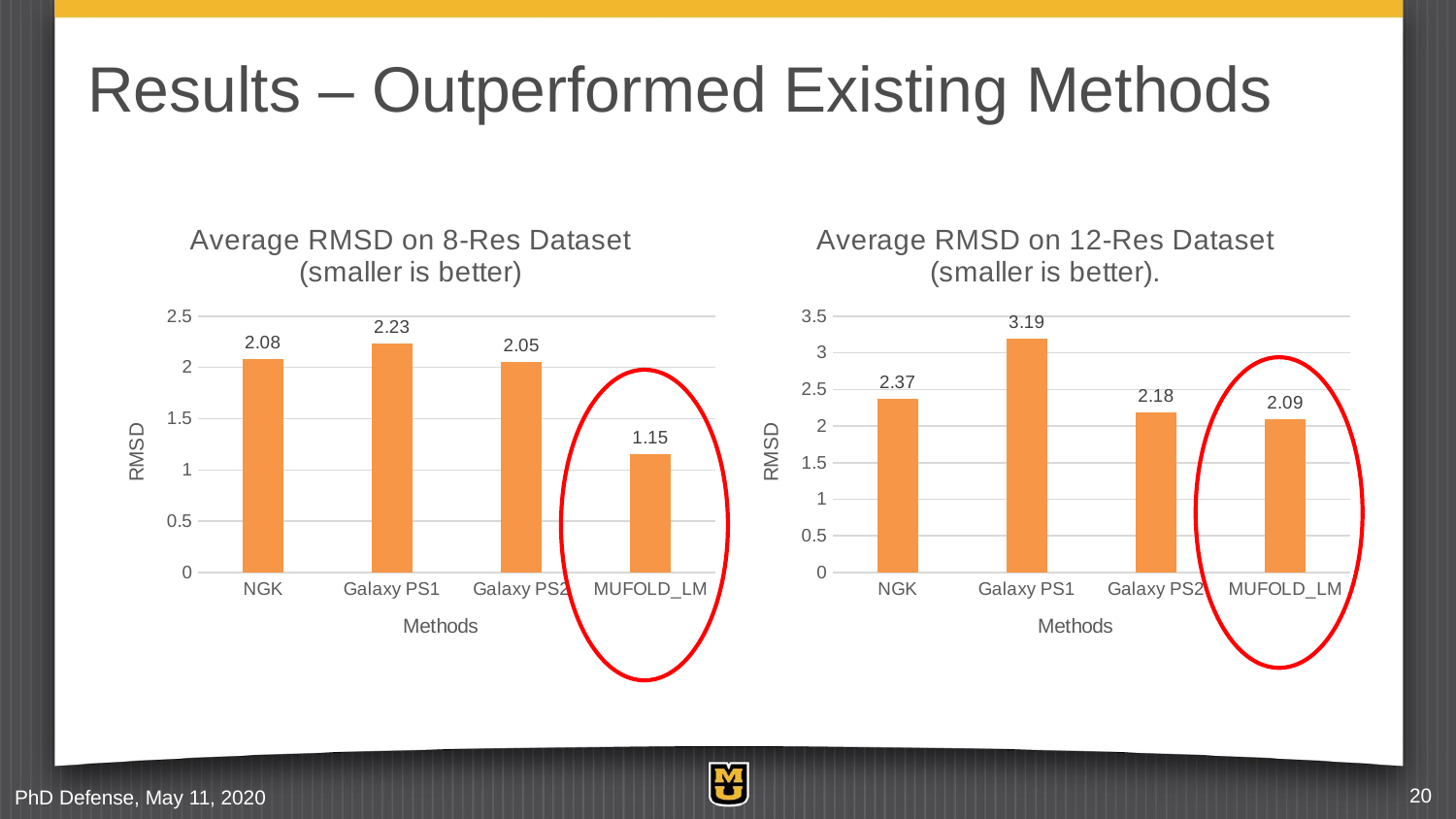
In the 'Average RMSD on 12-Res Dataset' chart, what is the value for Galaxy PS1? 3.19 In the 'Average RMSD on 8-Res Dataset' chart, what is the value for MUFOLD_LM? 1.15 In the 'Average RMSD on 12-Res Dataset' chart, which method has the lowest RMSD? MUFOLD_LM In the 'Average RMSD on 8-Res Dataset' chart, what is the difference between the values for NGK and MUFOLD_LM? 0.93 In the 'Average RMSD on 8-Res Dataset' chart, what is the value for Galaxy PS2? 2.05 In the 'Average RMSD on 8-Res Dataset' chart, is the value for MUFOLD_LM greater or less than 1.5? less What is the y-axis label on the 'Average RMSD on 12-Res Dataset' chart? RMSD In the 'Average RMSD on 12-Res Dataset' chart, what is the difference between the values for Galaxy PS1 and NGK? 0.82 In the 'Average RMSD on 12-Res Dataset' chart, which is larger, the value for NGK or the value for Galaxy PS2? NGK What kind of chart is the 'Average RMSD on 8-Res Dataset' chart? bar chart In the 'Average RMSD on 8-Res Dataset' chart, which method has the highest RMSD? Galaxy PS1 How many methods are shown in the 'Average RMSD on 12-Res Dataset' chart? 4